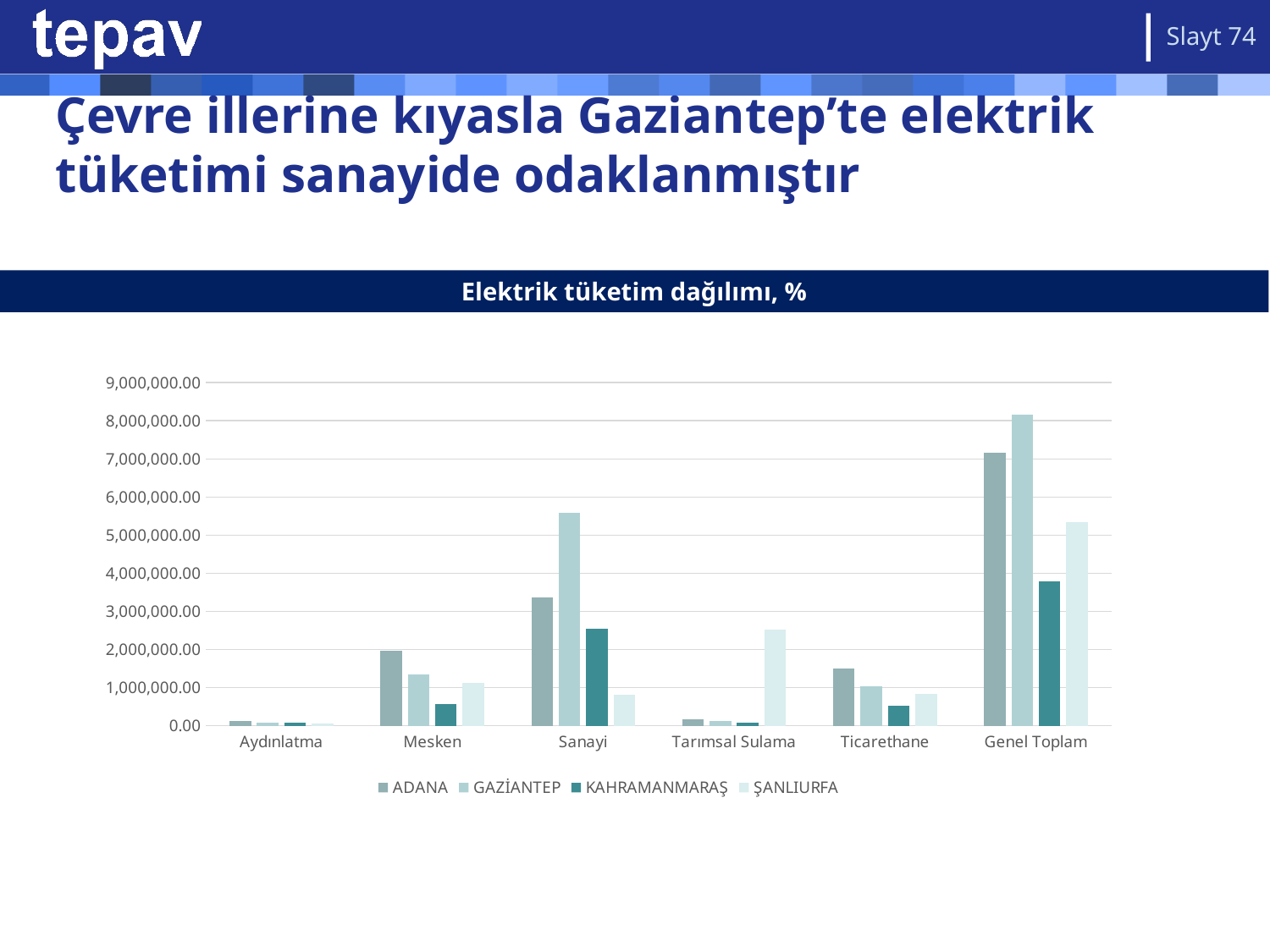
Which series has the highest value in the Sanayi category? GAZİANTEP How many series does the chart's legend list? 4 Which series has the lowest value in the Genel Toplam category? KAHRAMANMARAŞ In the Ticarethane category, which is larger: the value for KAHRAMANMARAŞ or the value for ŞANLIURFA? ŞANLIURFA In the Mesken category, which is larger: the value for ADANA or the value for GAZİANTEP? ADANA Which series has the highest value in the Tarımsal Sulama category? ŞANLIURFA What kind of chart is shown on the slide? Bar chart How many categories are shown on the x axis of the chart? 6 Is the value for GAZİANTEP in the Sanayi category greater or less than 5,000,000.00? greater Is the value for ADANA in the Genel Toplam category greater or less than 6,000,000.00? greater What is the title of the chart? Elektrik tüketim dağılımı, % Is the value for KAHRAMANMARAŞ in the Genel Toplam category greater or less than 4,000,000.00? less